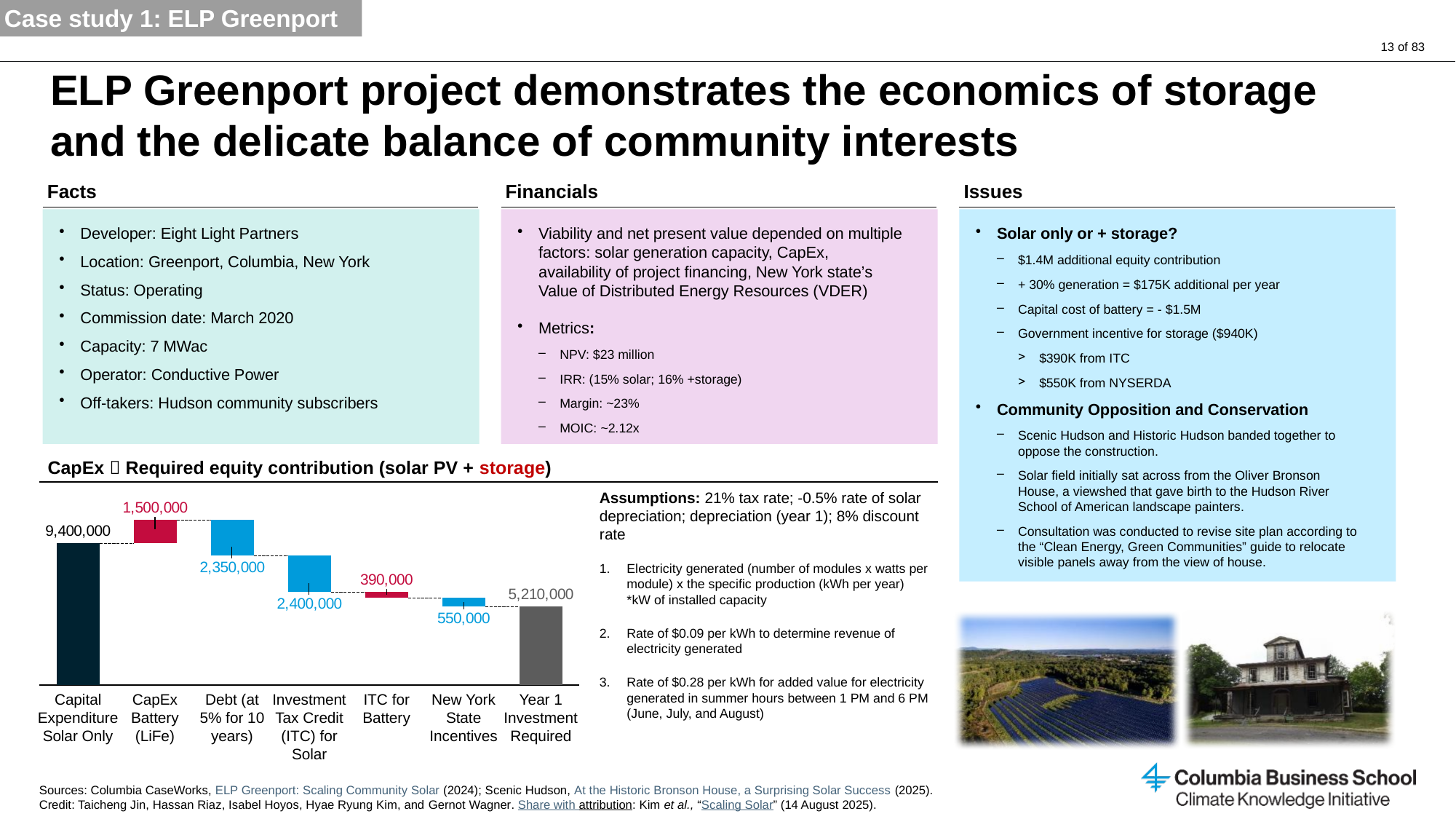
In the CapEx chart, what is the difference between Capital Expenditure Solar Only and Year 1 Investment Required? 4,190,000 In the CapEx chart, which is larger: Debt (at 5% for 10 years) or Investment Tax Credit (ITC) for Solar? Investment Tax Credit (ITC) for Solar What is the value for CapEx Battery (LiFe) in the CapEx chart? 1,500,000 How many categories are shown along the x axis of the CapEx chart? 7 What type of chart is shown under the heading "CapEx → Required equity contribution (solar PV + storage)"? bar chart (waterfall) Which category has the smallest value in the CapEx chart? ITC for Battery What colour is the Year 1 Investment Required bar in the CapEx chart? grey Which category has the largest value in the CapEx chart? Capital Expenditure Solar Only What is the value for Year 1 Investment Required in the CapEx chart? 5,210,000 What is the value for Capital Expenditure Solar Only in the CapEx chart? 9,400,000 What is the value for New York State Incentives in the CapEx chart? 550,000 What is the value for ITC for Battery in the CapEx chart? 390,000